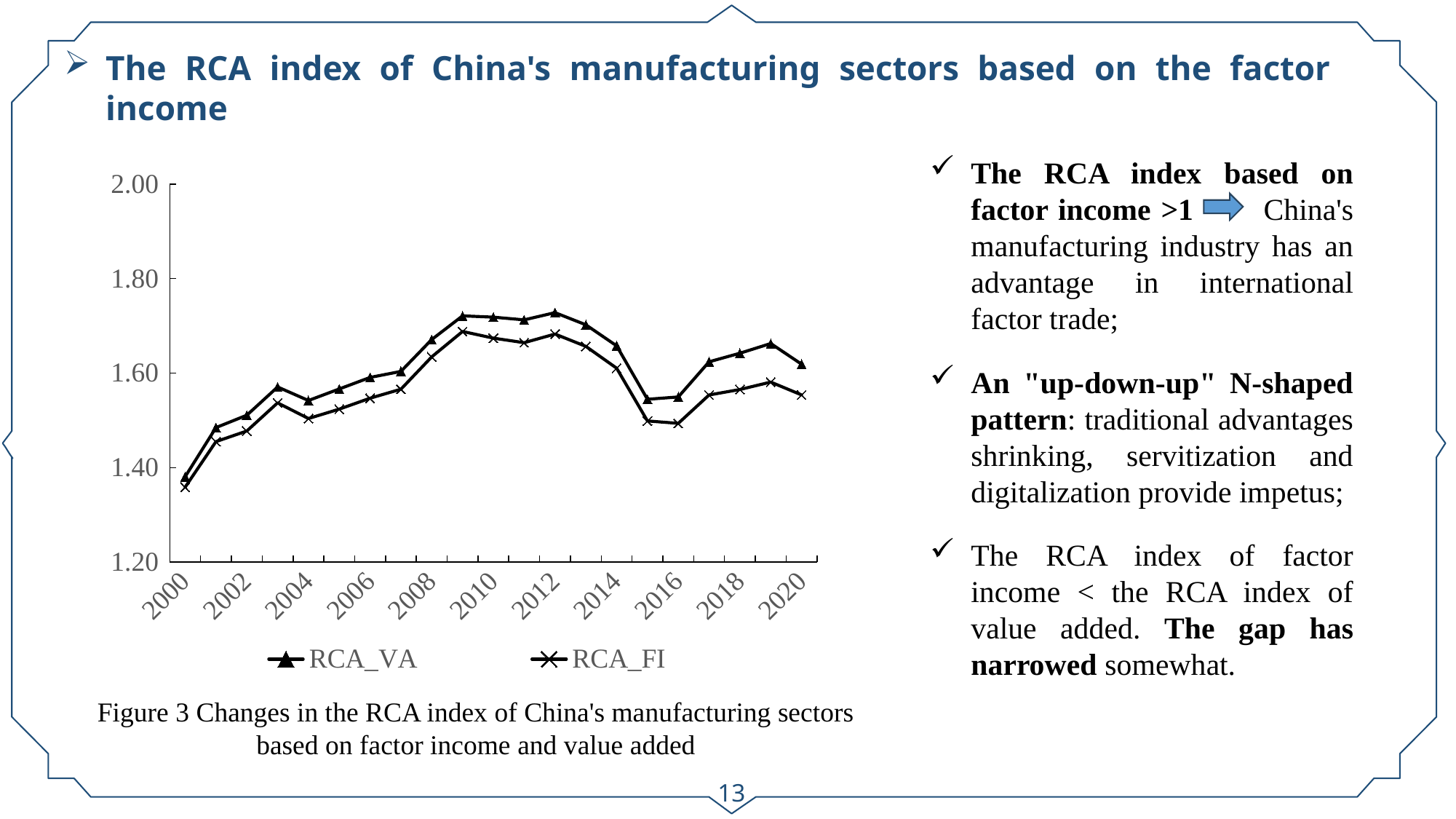
What kind of chart is shown on the slide? line chart In which year is the RCA_VA series at its lowest value? 2000 Between 2000 and 2009, does the RCA_VA series generally rise or fall? rise Is the value of RCA_FI in 2015 greater or less than 1.60? less In 2010, which series has the higher value, RCA_VA or RCA_FI? RCA_VA In which year is the RCA_FI series at its lowest value? 2000 Is the value of RCA_FI in 2000 greater or less than 1.40? less How many series does the chart legend list? 2 Is the value of RCA_VA in 2009 greater or less than 1.60? greater What are the two series named in the chart legend? RCA_VA and RCA_FI Between 2012 and 2015, does the RCA_FI series rise or fall? fall How many year labels are shown along the x axis of the chart? 11